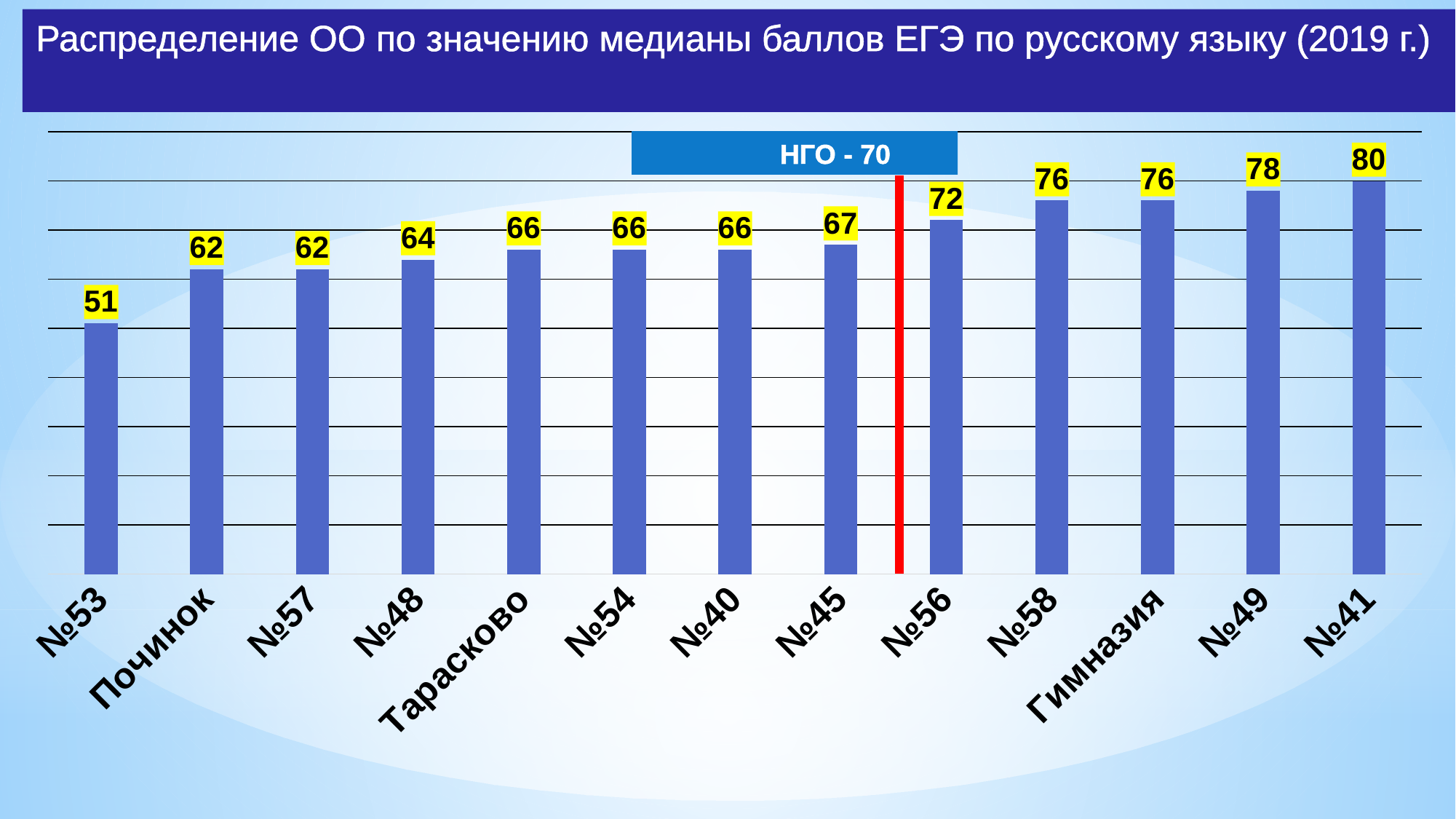
What is the value shown for Тарасково? 66 What is the value shown for Гимназия? 76 What is the median Russian language EGE score for №53? 51 What is the difference between the values for №49 and Починок? 16 Which category has the highest value? №41 Which category has the lowest value? №53 What value is given for НГО in the label above the chart? 70 How many categories are shown on the x axis? 13 What kind of chart is shown on the slide? Bar chart What is the difference between the values for №41 and №53? 29 Which is larger, the value for №45 or the value for №48? №45 What is the value shown for №56? 72